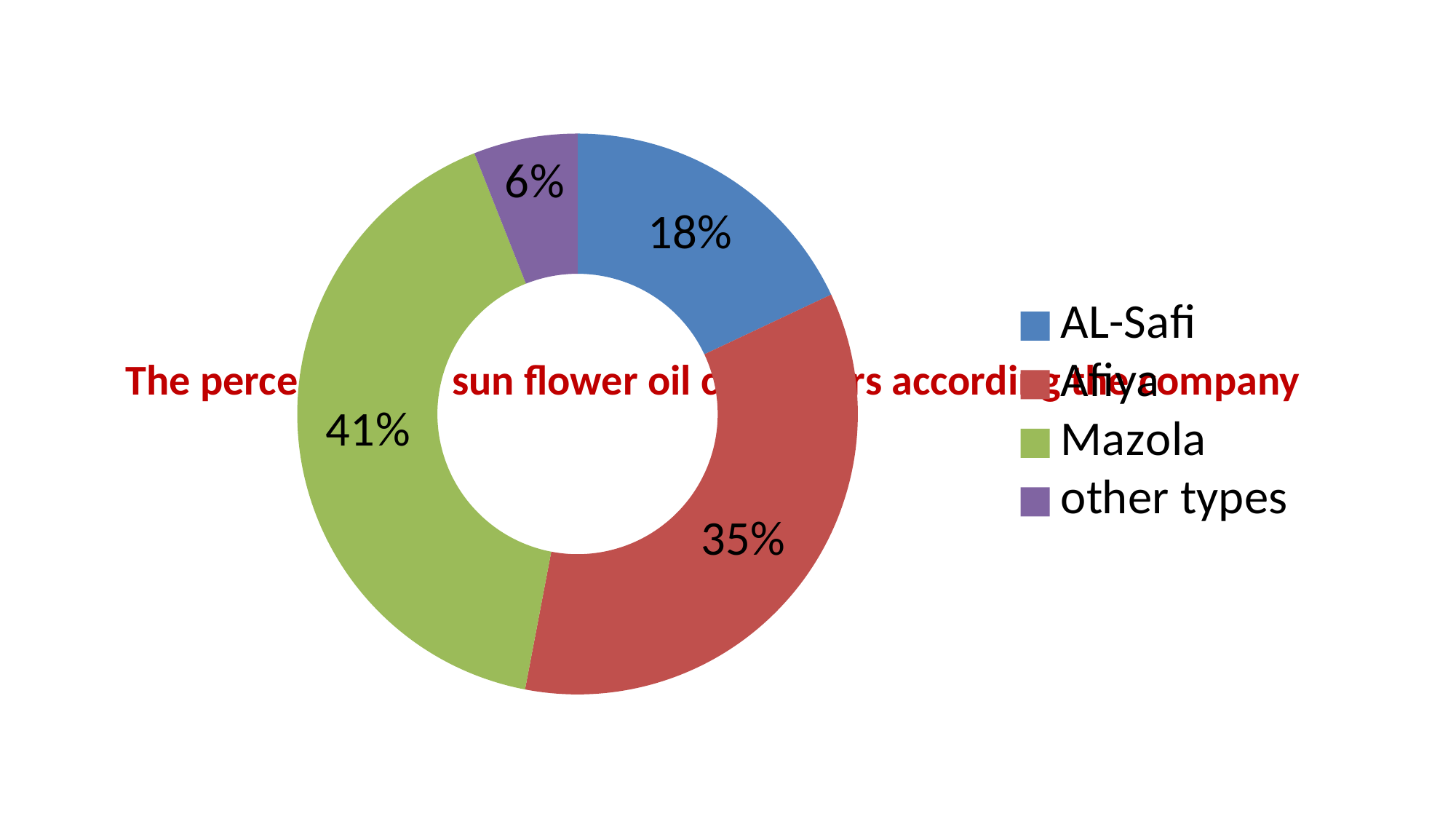
What colour is the Mazola slice? green What is the difference in percentage points between Mazola and Afiya? 6 Which category has the smallest slice? other types What percentage does the AL-Safi slice show? 18% What percentage is labelled for other types? 6% What percentage of the doughnut chart is Mazola? 41% What kind of chart is shown on the slide? doughnut chart Which is larger, the AL-Safi slice or the Afiya slice? Afiya Which company has the largest share of the chart? Mazola What is the value shown for Afiya? 35% How many slices does the chart have? 4 Which legend entry is shown in purple? other types